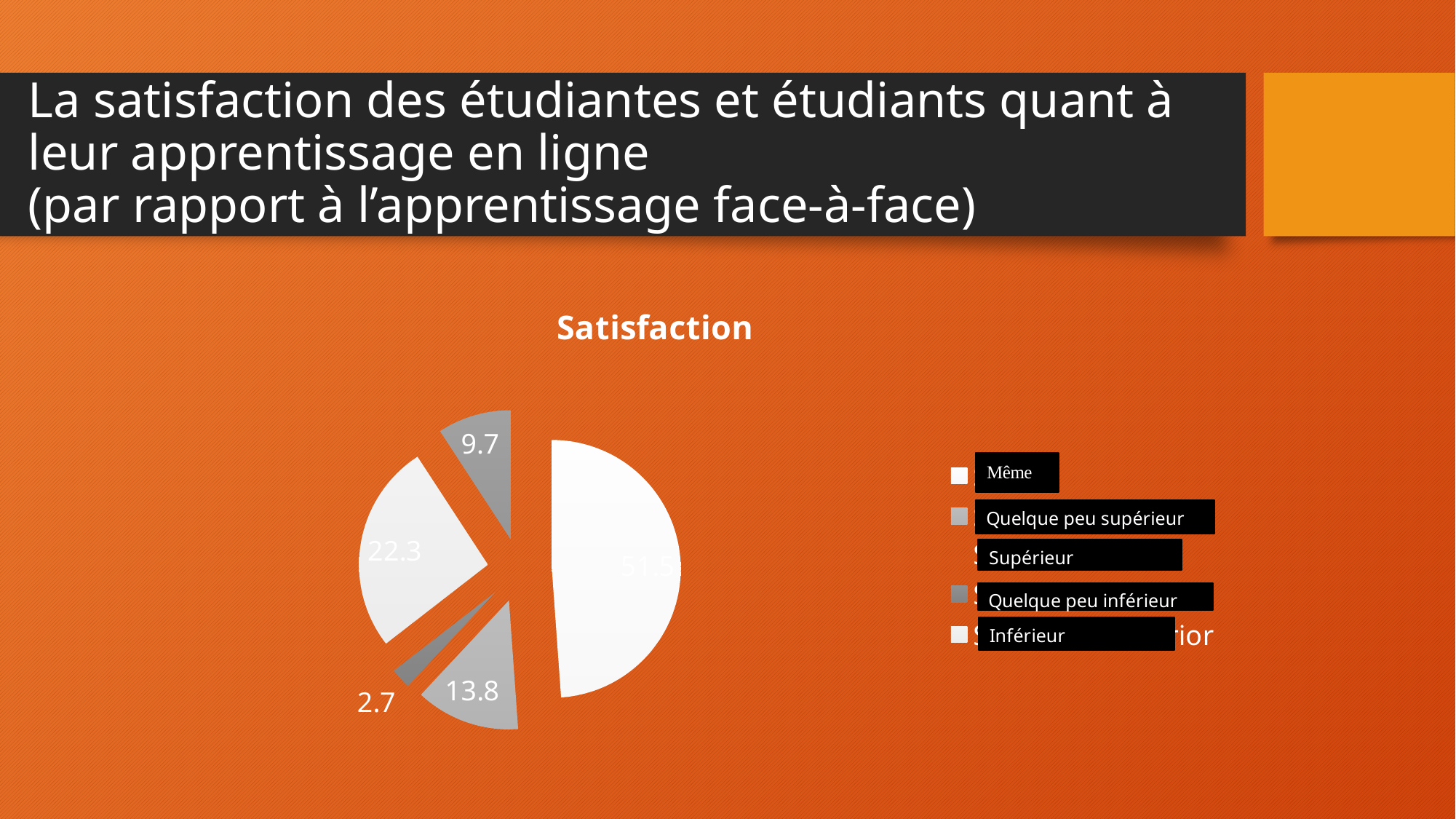
What is the value of the smallest slice in the pie chart? 2.7 Is the value of the largest slice greater or less than 50? greater What kind of chart is shown on the slide? pie chart Which is larger, the slice labelled 22.3 or the slice labelled 13.8? 22.3 What is the title of the chart? Satisfaction How many slices does the pie chart have? 5 What is the value of the largest slice in the pie chart? 51.5 How many entries does the legend list? 5 What is the difference between the slices labelled 22.3 and 9.7? 12.6 Which legend entry is listed first? Même What is the difference between the largest slice (51.5) and the smallest slice (2.7)? 48.8 What is the value shown for the 'Même' slice? 51.5